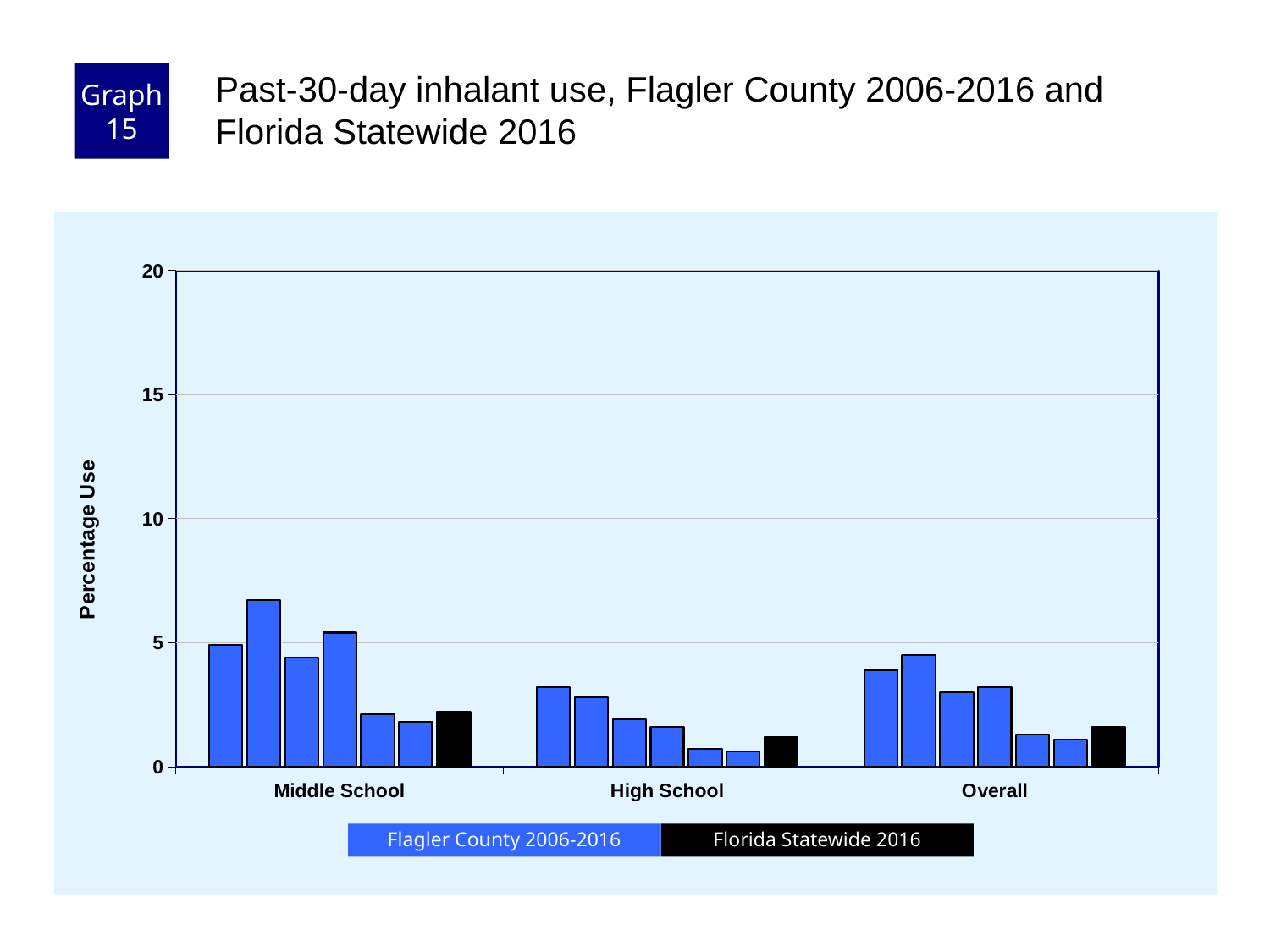
How many categories are shown on the x axis? 3 Is the tallest Flagler County bar for High School greater or less than 5? less What kind of chart is shown on the slide? bar chart Is the Florida Statewide 2016 value larger for Middle School or for High School? Middle School Is the Florida Statewide 2016 value for Overall greater or less than 5? less Is the Florida Statewide 2016 value for Middle School greater or less than 5? less What is the label on the y axis? Percentage Use Which colour represents Florida Statewide 2016 in the legend? black Which category has the lowest Florida Statewide 2016 value? High School Which category has the highest Florida Statewide 2016 value? Middle School How many series does the legend list? 2